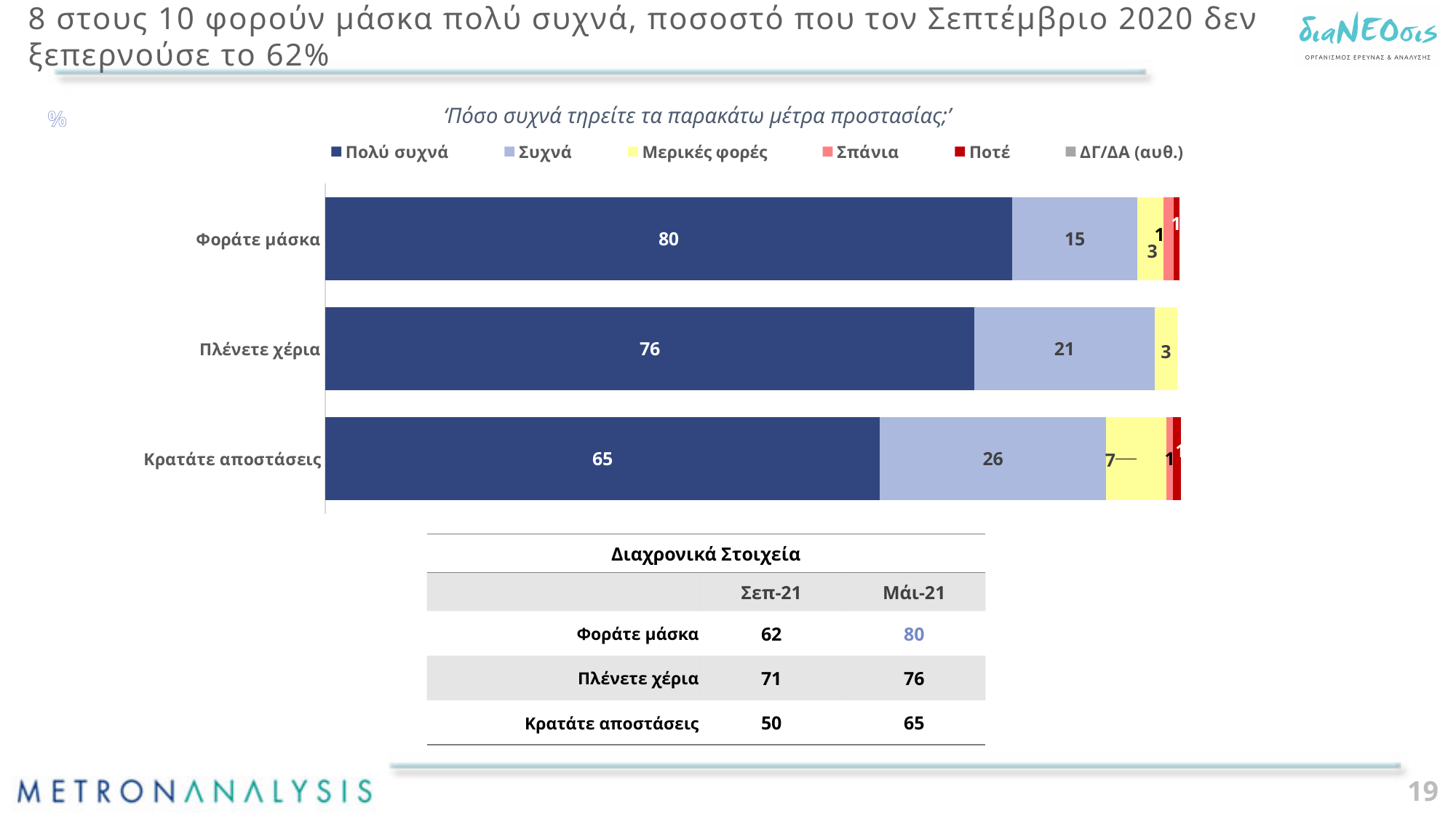
What percentage of respondents answered 'Πολύ συχνά' for 'Φοράτε μάσκα'? 80 What is the 'Μερικές φορές' value for 'Κρατάτε αποστάσεις'? 7 What is the difference between the 'Πολύ συχνά' values for 'Φοράτε μάσκα' and 'Κρατάτε αποστάσεις'? 15 How many categories are shown in the bar chart? 3 How many series does the legend list? 6 Which is larger: the 'Συχνά' value for 'Πλένετε χέρια' or for 'Φοράτε μάσκα'? Πλένετε χέρια Which series is shown in dark blue in the legend? Πολύ συχνά What is the 'Συχνά' value for 'Κρατάτε αποστάσεις'? 26 What is the 'Συχνά' value for 'Πλένετε χέρια'? 21 Which category has the highest 'Πολύ συχνά' value? Φοράτε μάσκα Which category has the lowest 'Πολύ συχνά' value? Κρατάτε αποστάσεις What kind of chart is shown on the slide? Stacked bar chart